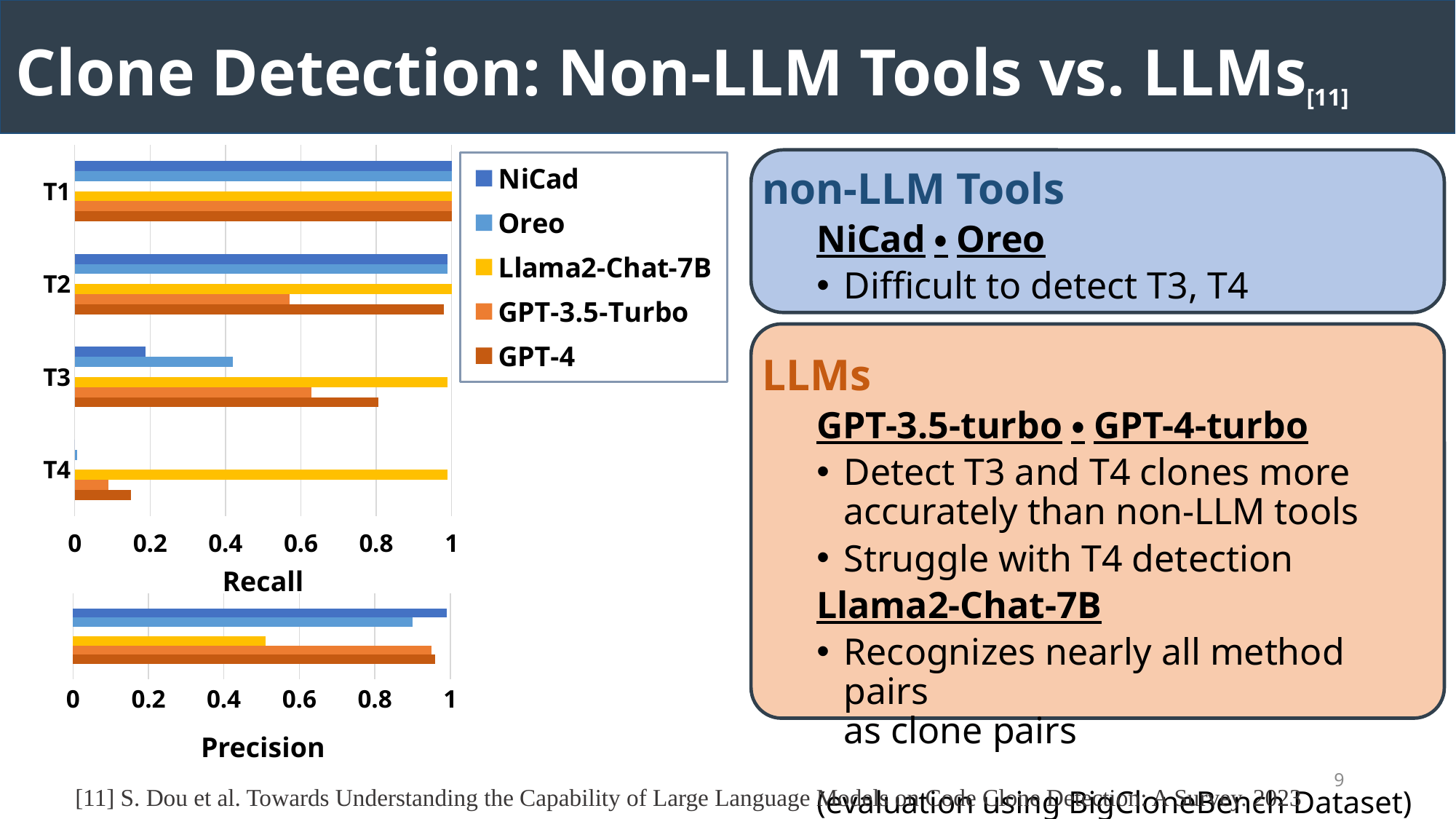
In the Recall chart, for T3, which is larger: Oreo or GPT-4? GPT-4 In the Precision chart, which series has the lowest precision? Llama2-Chat-7B What is the axis label of the top chart? Recall In the Precision chart, is the value for Llama2-Chat-7B greater or less than 0.6? less In the Recall chart, which series has the highest recall for T4? Llama2-Chat-7B In the Recall chart, is the value for GPT-3.5-Turbo at T2 greater or less than 0.8? less In the Recall chart, is the value for NiCad at T3 greater or less than 0.4? less What kind of chart is the Recall chart? bar chart How many series does the legend list? 5 In the Recall chart, which series has the lowest recall for T3? NiCad In the Recall chart, how many clone type categories are shown on the vertical axis? 4